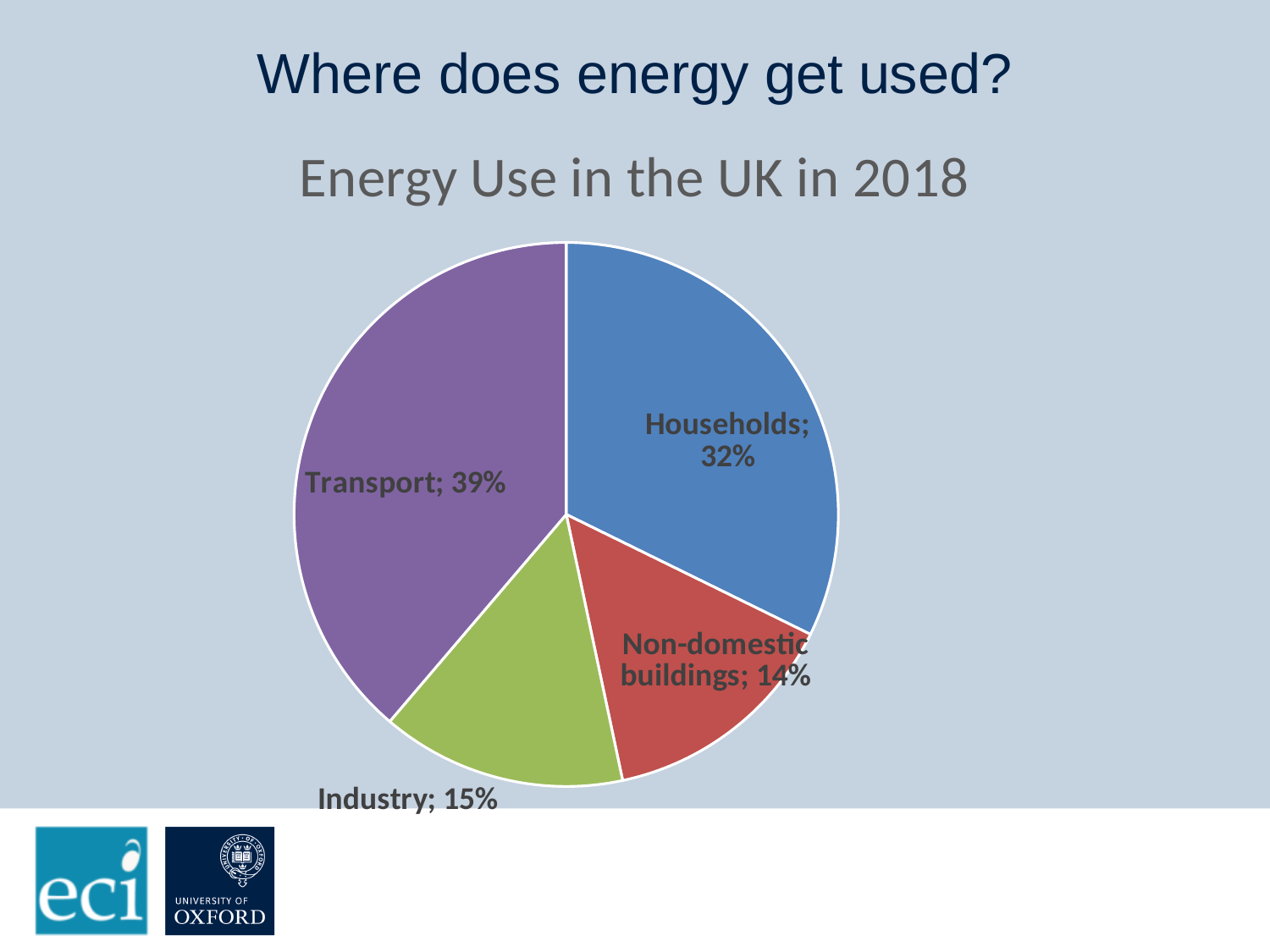
What is the difference in percentage points between Transport and Households? 7 What share of energy use does Transport account for? 39% What is the title of the chart? Energy Use in the UK in 2018 What share of energy use does Households account for? 32% What share of energy use does Industry account for? 15% Which category has the smallest share of energy use? Non-domestic buildings Which has a larger share, Households or Transport? Transport Which category has the largest share of energy use? Transport What share of energy use do Non-domestic buildings account for? 14% What kind of chart is shown on the slide? Pie chart What is the difference in percentage points between Households and Industry? 17 How many categories are shown in the pie chart? 4